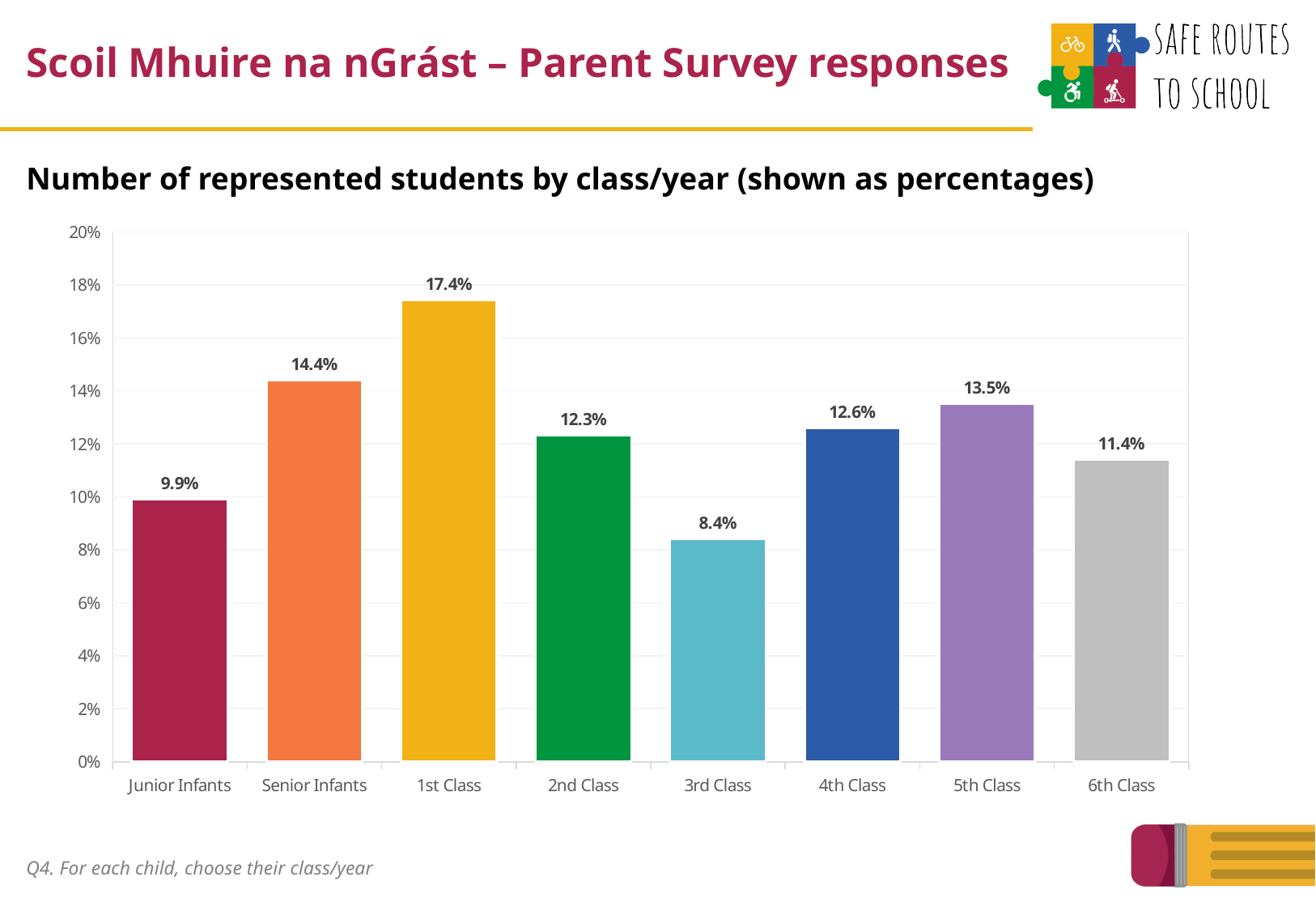
What percentage is shown for 5th Class? 13.5% What is the title of the chart? Number of represented students by class/year (shown as percentages) Which is larger, the value for 4th Class or the value for 2nd Class? 4th Class What percentage of represented students are in 1st Class? 17.4% What is the difference between the values for Senior Infants and 6th Class? 3.0% How many classes are shown on the x axis? 8 Is the value for Senior Infants greater or less than 14%? greater Which class has the lowest percentage of represented students? 3rd Class Which class has the highest percentage of represented students? 1st Class What is the difference between the percentages for 1st Class and 3rd Class? 9.0% What is the value shown for Junior Infants? 9.9% What kind of chart is shown on the slide? Bar chart